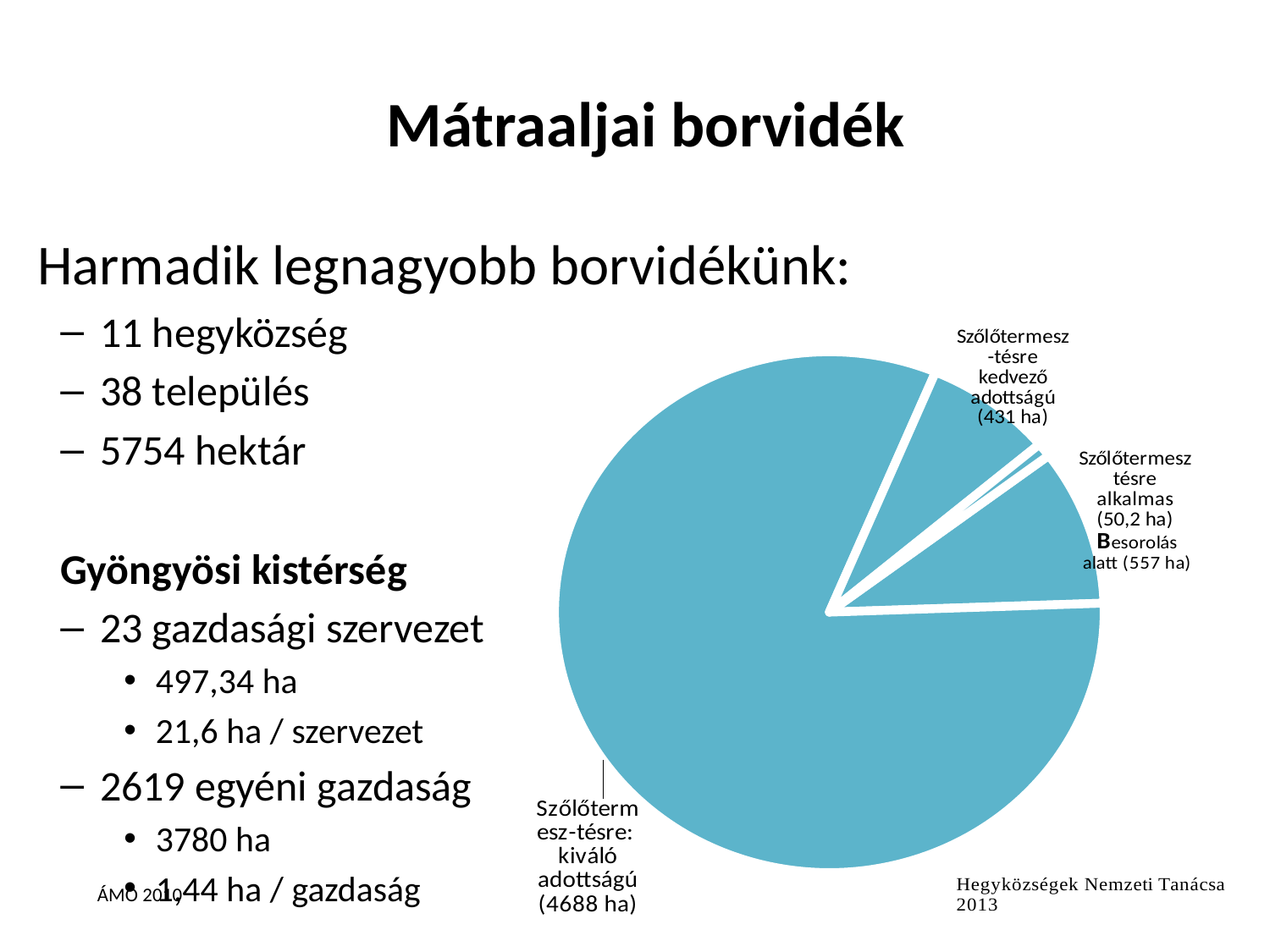
What area is shown for 'Besorolás alatt' in the pie chart? 557 ha Which category has the largest slice in the pie chart? Szőlőtermesztésre kiváló adottságú How much larger is the 'Besorolás alatt' area than the 'Szőlőtermesztésre kedvező adottságú' area? 126 ha Which category has the smallest slice in the pie chart? Szőlőtermesztésre alkalmas What area is shown for 'Szőlőtermesztésre alkalmas' in the pie chart? 50,2 ha How many slices does the pie chart have? 4 Which is larger: 'Besorolás alatt' or 'Szőlőtermesztésre kedvező adottságú'? Besorolás alatt What source is cited below the pie chart? Hegyközségek Nemzeti Tanácsa 2013 What area is shown for 'Szőlőtermesztésre kedvező adottságú' in the pie chart? 431 ha What is the difference between the 'Szőlőtermesztésre kiváló adottságú' area and the 'Besorolás alatt' area? 4131 ha What area is shown for 'Szőlőtermesztésre kiváló adottságú' in the pie chart? 4688 ha What kind of chart is shown on the slide? pie chart